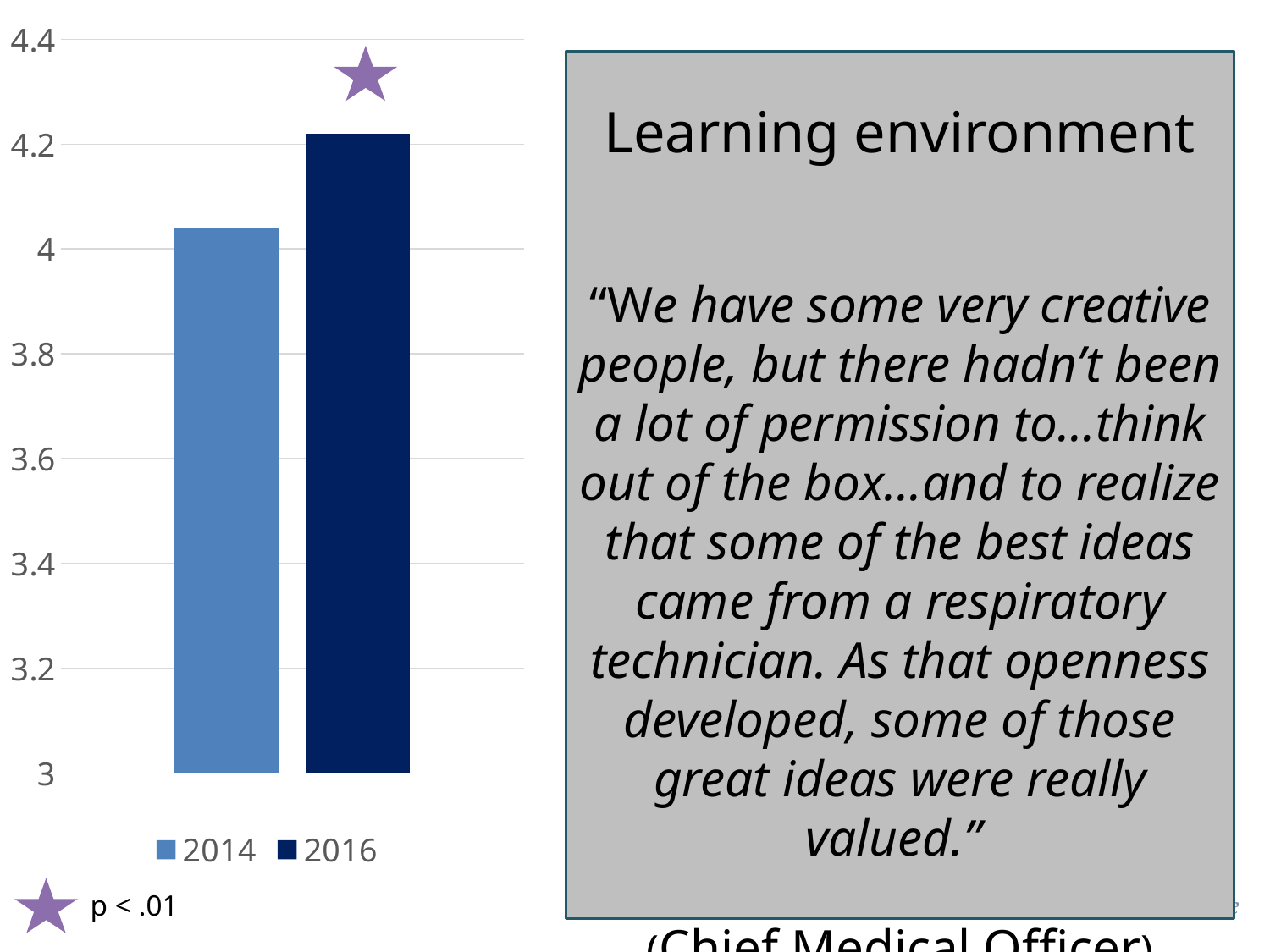
Which series has the higher bar, 2014 or 2016? 2016 What does the star symbol above the 2016 bar indicate, according to the key below the chart? p < .01 Do the values rise or fall from 2014 to 2016? rise Which series has the lowest bar in the chart? 2014 What kind of chart is shown on the slide? bar chart Is the value for 2014 greater or less than 4? greater What is the lowest value shown on the chart's vertical axis? 3 Is the value for 2014 greater or less than 4.2? less How many series does the chart's legend list? 2 Is the value for 2016 greater or less than 4? greater How many bars are plotted in the chart? 2